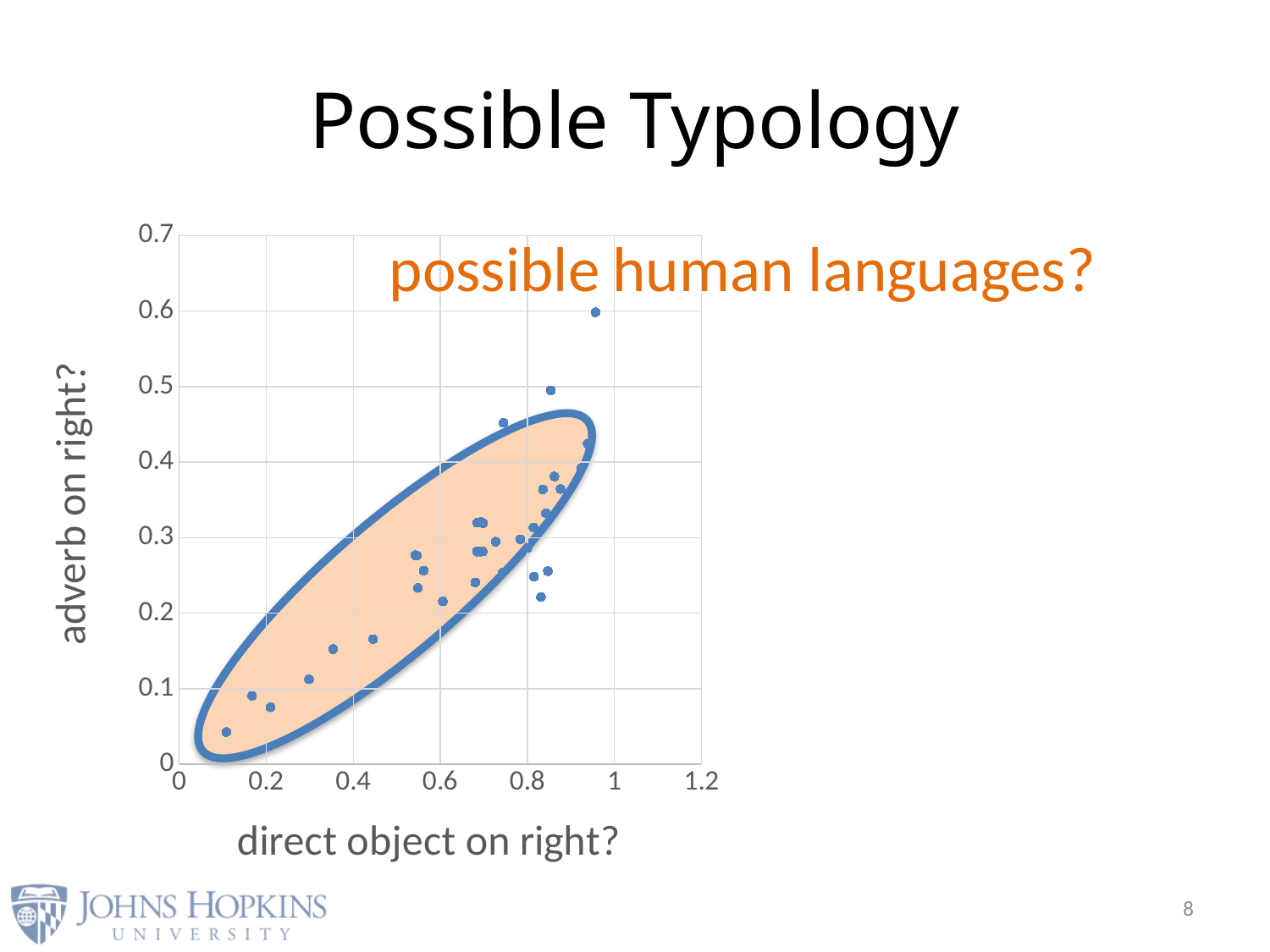
Is the y value of the highest point greater or less than 0.7? less What kind of chart is shown on the slide? scatter plot What is the largest tick value shown on the x axis? 1.2 Is the x value of the highest point in the chart greater or less than 0.8? greater Is the x value of the leftmost point in the chart greater or less than 0.2? less What is the label of the y axis of the chart? adverb on right? As the x value (direct object on right?) increases, do the y values (adverb on right?) generally rise or fall? rise What is the label of the x axis of the chart? direct object on right?